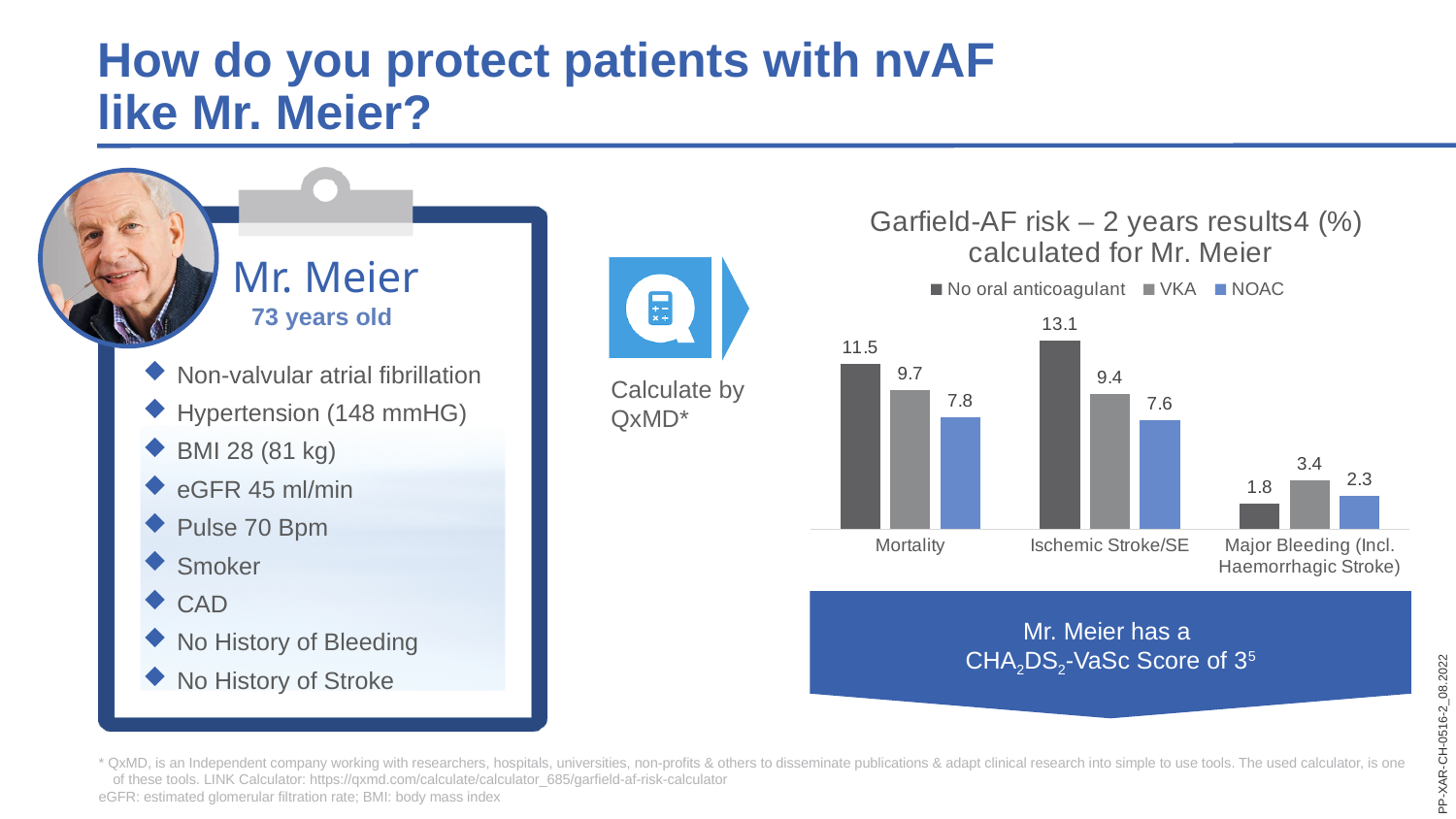
Which series has the highest value in the Ischemic Stroke/SE category? No oral anticoagulant What is the difference between the VKA and No oral anticoagulant values in the Ischemic Stroke/SE category? 3.7 How many categories are shown on the x axis of the chart? 3 What is the value for NOAC in the Ischemic Stroke/SE category? 7.6 What is the title of the chart? Garfield-AF risk – 2 years results4 (%) calculated for Mr. Meier What kind of chart is shown on the slide? Bar chart Which is larger in the Major Bleeding (Incl. Haemorrhagic Stroke) category: VKA or NOAC? VKA What is the value for VKA in the Major Bleeding (Incl. Haemorrhagic Stroke) category? 3.4 Which series has the lowest value in the Major Bleeding (Incl. Haemorrhagic Stroke) category? No oral anticoagulant What is the value for No oral anticoagulant in the Mortality category? 11.5 How many series does the chart legend list? 3 What is the difference between the No oral anticoagulant and NOAC values in the Mortality category? 3.7